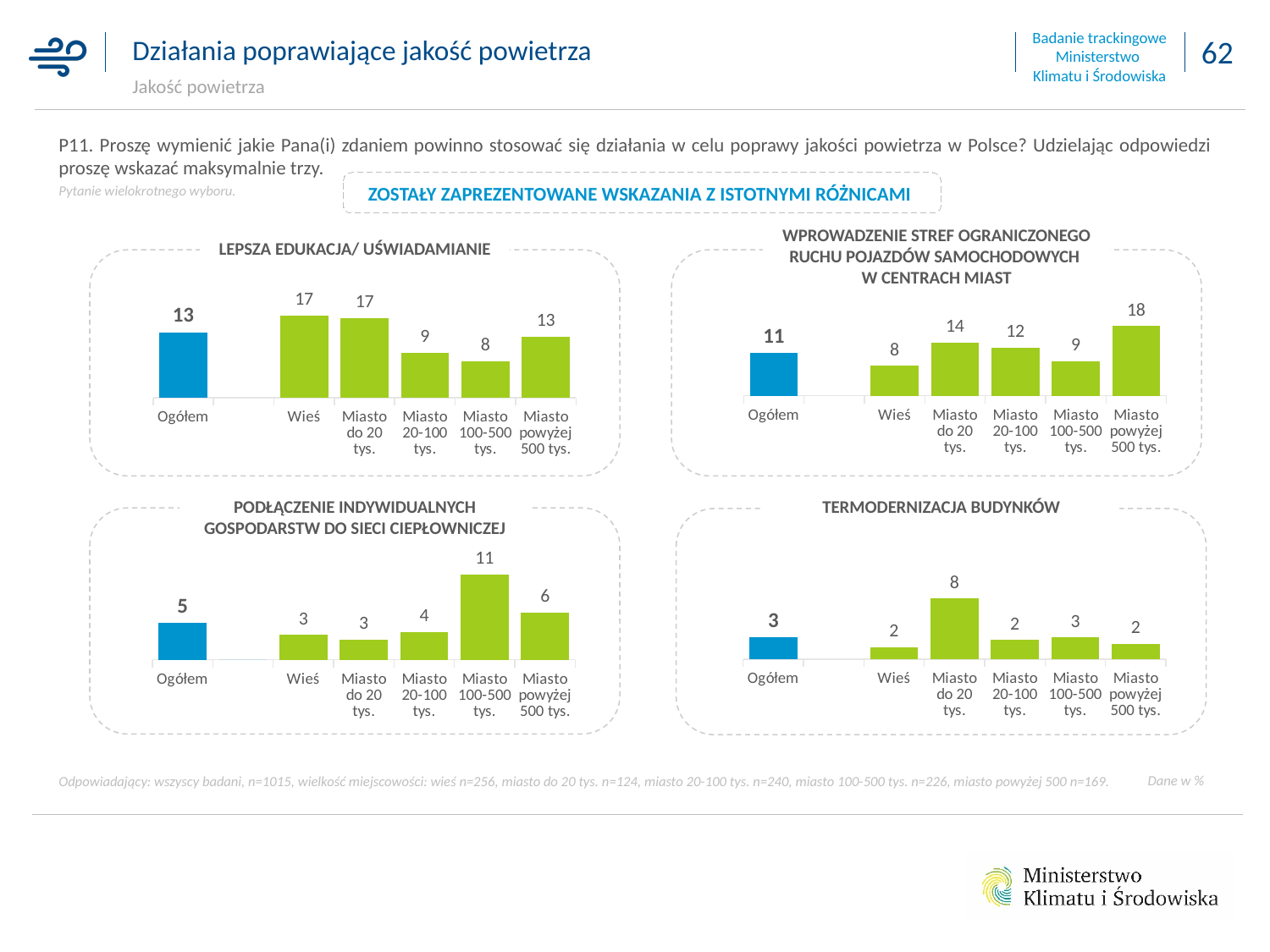
In the chart titled "LEPSZA EDUKACJA/ UŚWIADAMIANIE", what is the difference between Wieś and Miasto 20-100 tys.? 8 In the chart titled "LEPSZA EDUKACJA/ UŚWIADAMIANIE", what is the value for Ogółem? 13 In the chart titled "PODŁĄCZENIE INDYWIDUALNYCH GOSPODARSTW DO SIECI CIEPŁOWNICZEJ", what is the value for Miasto powyżej 500 tys.? 6 In the chart titled "LEPSZA EDUKACJA/ UŚWIADAMIANIE", how many categories are shown on the x axis? 6 What type of chart is the chart titled "TERMODERNIZACJA BUDYNKÓW"? Bar chart In the chart titled "WPROWADZENIE STREF OGRANICZONEGO RUCHU POJAZDÓW SAMOCHODOWYCH W CENTRACH MIAST", which category has the highest value? Miasto powyżej 500 tys. In the chart titled "PODŁĄCZENIE INDYWIDUALNYCH GOSPODARSTW DO SIECI CIEPŁOWNICZEJ", which category has the highest value? Miasto 100-500 tys. In the chart titled "WPROWADZENIE STREF OGRANICZONEGO RUCHU POJAZDÓW SAMOCHODOWYCH W CENTRACH MIAST", what is the value for Wieś? 8 In the chart titled "WPROWADZENIE STREF OGRANICZONEGO RUCHU POJAZDÓW SAMOCHODOWYCH W CENTRACH MIAST", what is the difference between Miasto powyżej 500 tys. and Ogółem? 7 In the chart titled "TERMODERNIZACJA BUDYNKÓW", what is the value for Miasto do 20 tys.? 8 In the chart titled "TERMODERNIZACJA BUDYNKÓW", which is larger: the value for Miasto do 20 tys. or the value for Miasto 100-500 tys.? Miasto do 20 tys. In the chart titled "LEPSZA EDUKACJA/ UŚWIADAMIANIE", what is the value for Miasto 100-500 tys.? 8